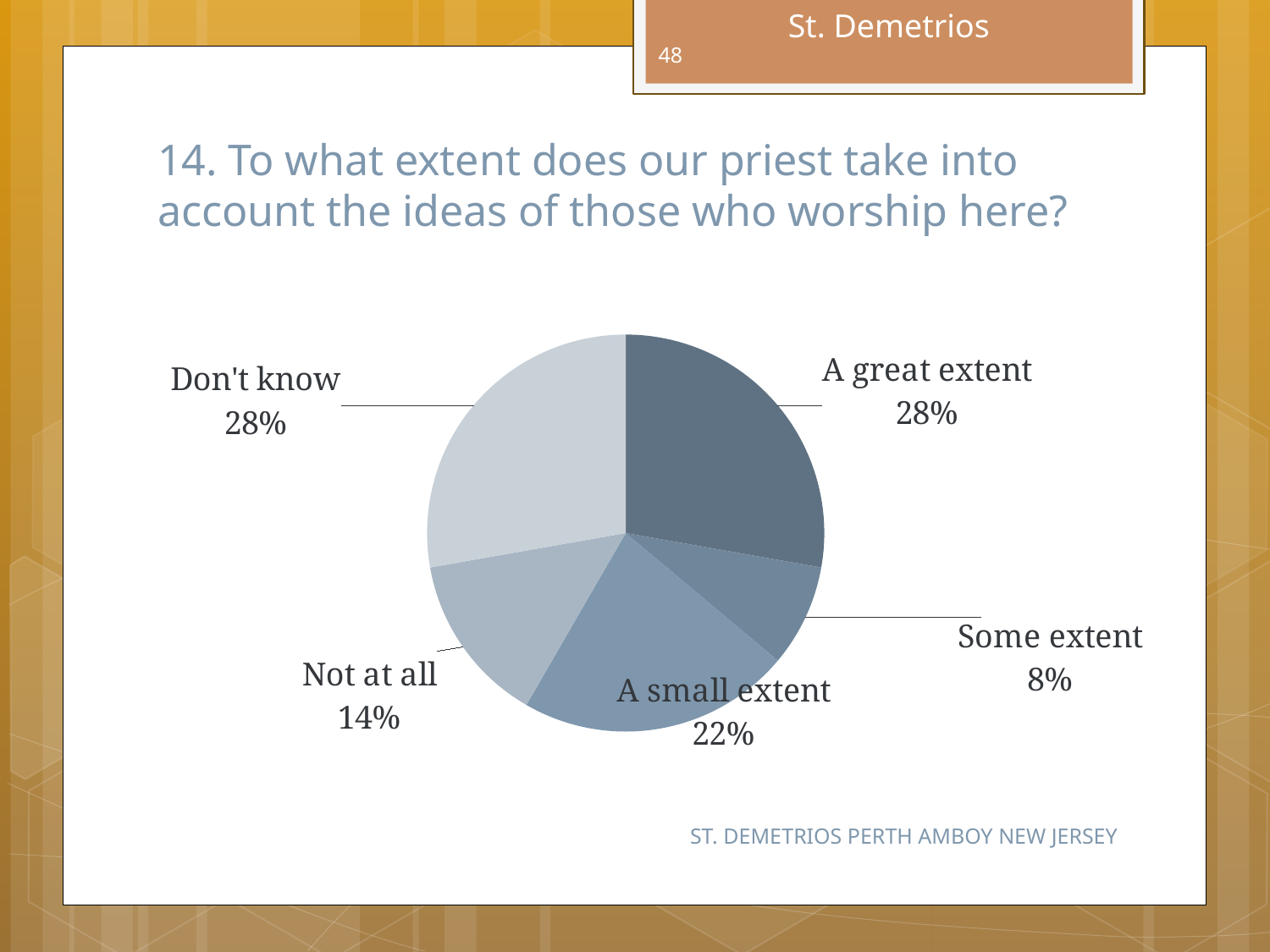
What percentage of respondents answered "Some extent"? 8% What is the combined share of "A great extent" and "Some extent"? 36% What percentage of respondents answered "A great extent"? 28% Which response has the smallest share of the pie? Some extent Which is larger, the share for "A small extent" or the share for "Not at all"? A small extent What is the difference in percentage points between "A great extent" and "Some extent"? 20 What is the difference in percentage points between "A small extent" and "Not at all"? 8 What percentage of respondents answered "A small extent"? 22% How many response categories are shown in the pie chart? 5 What percentage of respondents answered "Don't know"? 28% What percentage of respondents answered "Not at all"? 14% What type of chart is shown on the slide? Pie chart